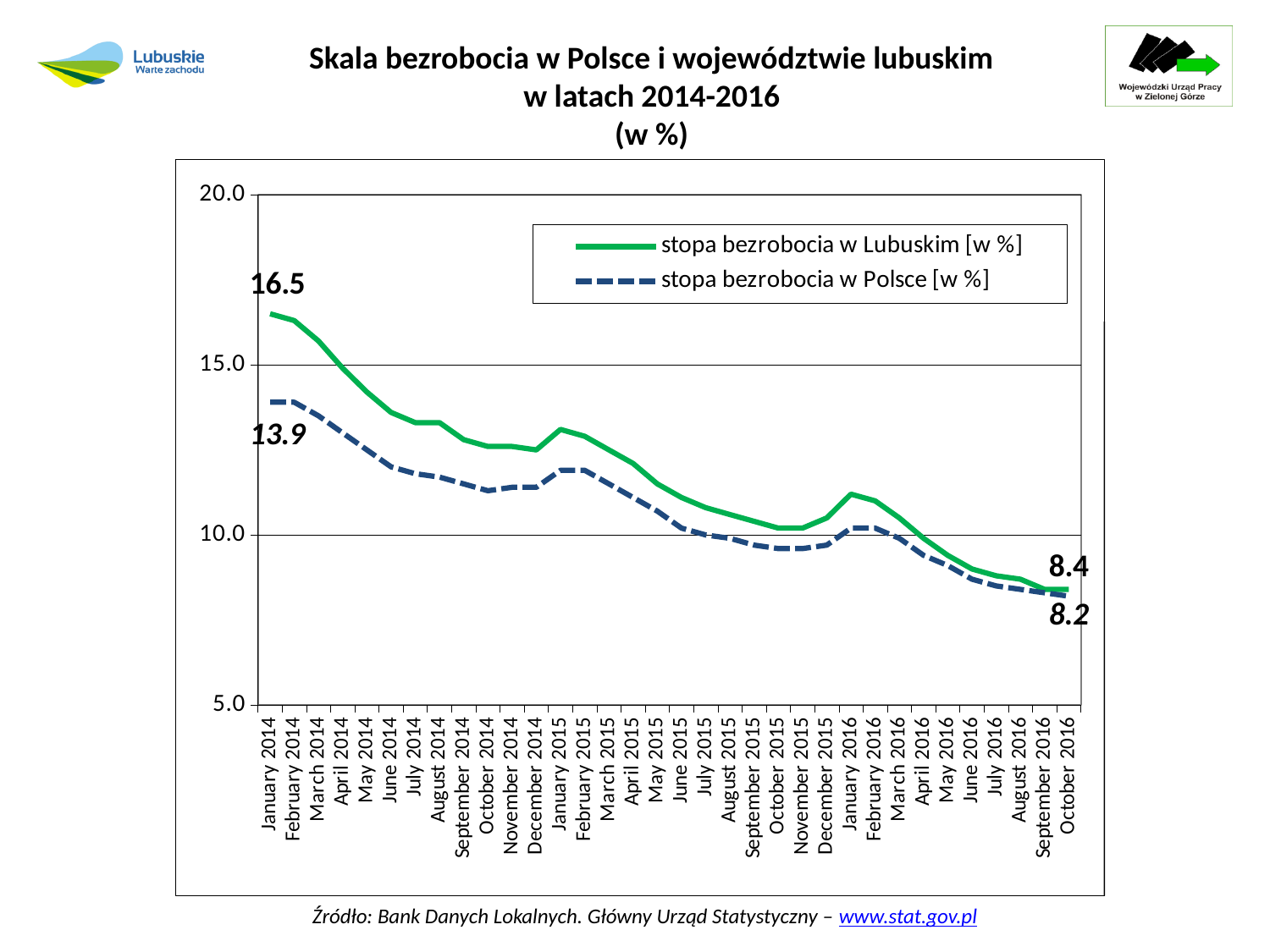
Is the value for Poland in October 2015 greater or less than 10.0? less What is the unemployment rate in Poland (stopa bezrobocia w Polsce) in January 2014? 13.9 In January 2014, how much higher is the Lubuskie unemployment rate than the Poland rate? 2.6 Do the unemployment rates generally rise or fall from January 2014 to October 2016? fall In which month does the Lubuskie series reach its highest value? January 2014 How many series does the legend list? 2 What is the unemployment rate in Poland in October 2016? 8.2 What is the unemployment rate in Lubuskie in October 2016? 8.4 What is the unemployment rate in Lubuskie (stopa bezrobocia w Lubuskim) in January 2014? 16.5 In January 2014, which series has the higher value: Lubuskie or Poland? Lubuskie What kind of chart is shown on the slide? line chart By how much did the Lubuskie unemployment rate fall between January 2014 and October 2016? 8.1